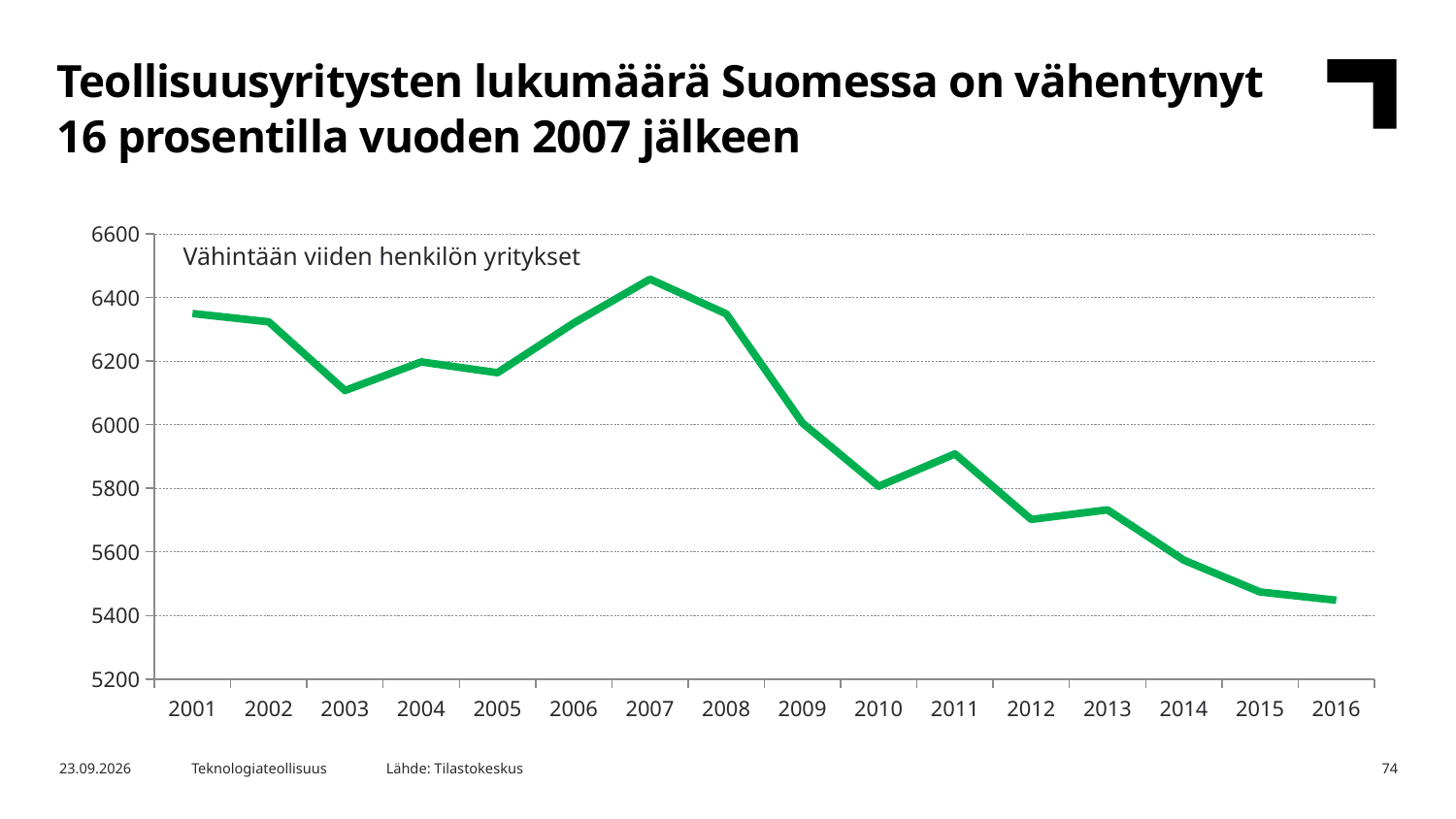
What text label appears inside the plot area of the chart? Vähintään viiden henkilön yritykset Which year has the higher value, 2003 or 2004? 2004 Does the line generally rise or fall from 2007 to 2016? Fall Which year has the higher value, 2010 or 2011? 2011 Is the value for 2003 greater or less than 6200? less Is the value for 2007 greater or less than 6400? greater How many years are plotted on the x axis of the chart? 16 What kind of chart is shown on the slide? Line chart In which year does the line reach its lowest value? 2016 Is the value for 2011 greater or less than 6000? less In which year does the line reach its highest value? 2007